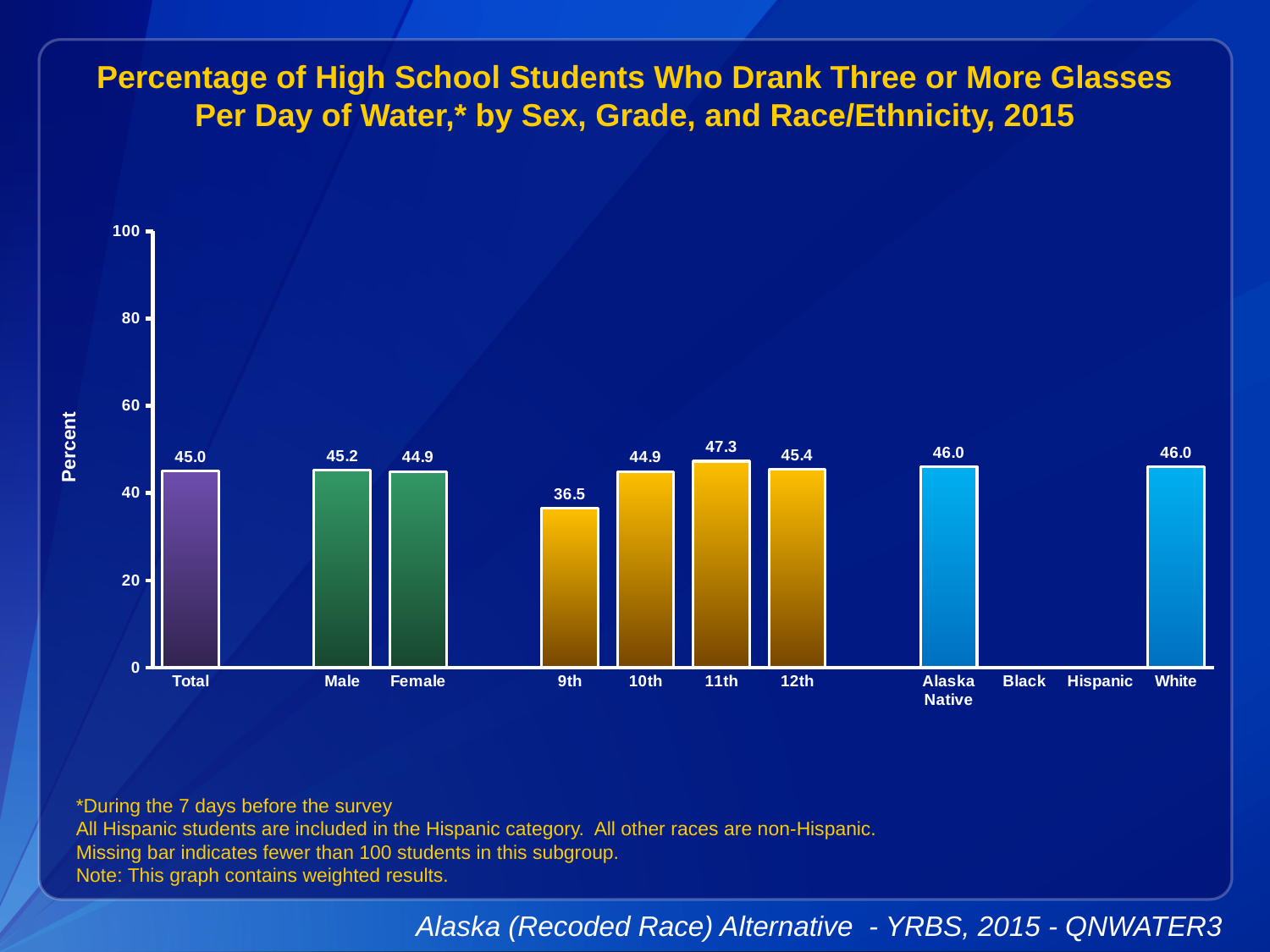
What is the value for 9th grade? 36.5 Which category has the highest value? 11th What is the value for 11th grade? 47.3 Is the value for 9th grade greater or less than 40? less Which is larger, the value for 12th grade or the value for 10th grade? 12th What is the value for Alaska Native? 46.0 What is the value for Total? 45.0 What is the difference between the values for Male and Female? 0.3 Which category has the lowest value among the bars shown? 9th What is the difference between the values for 11th and 9th grade? 10.8 How many categories are labeled on the x axis? 11 What kind of chart is shown on the slide? bar chart